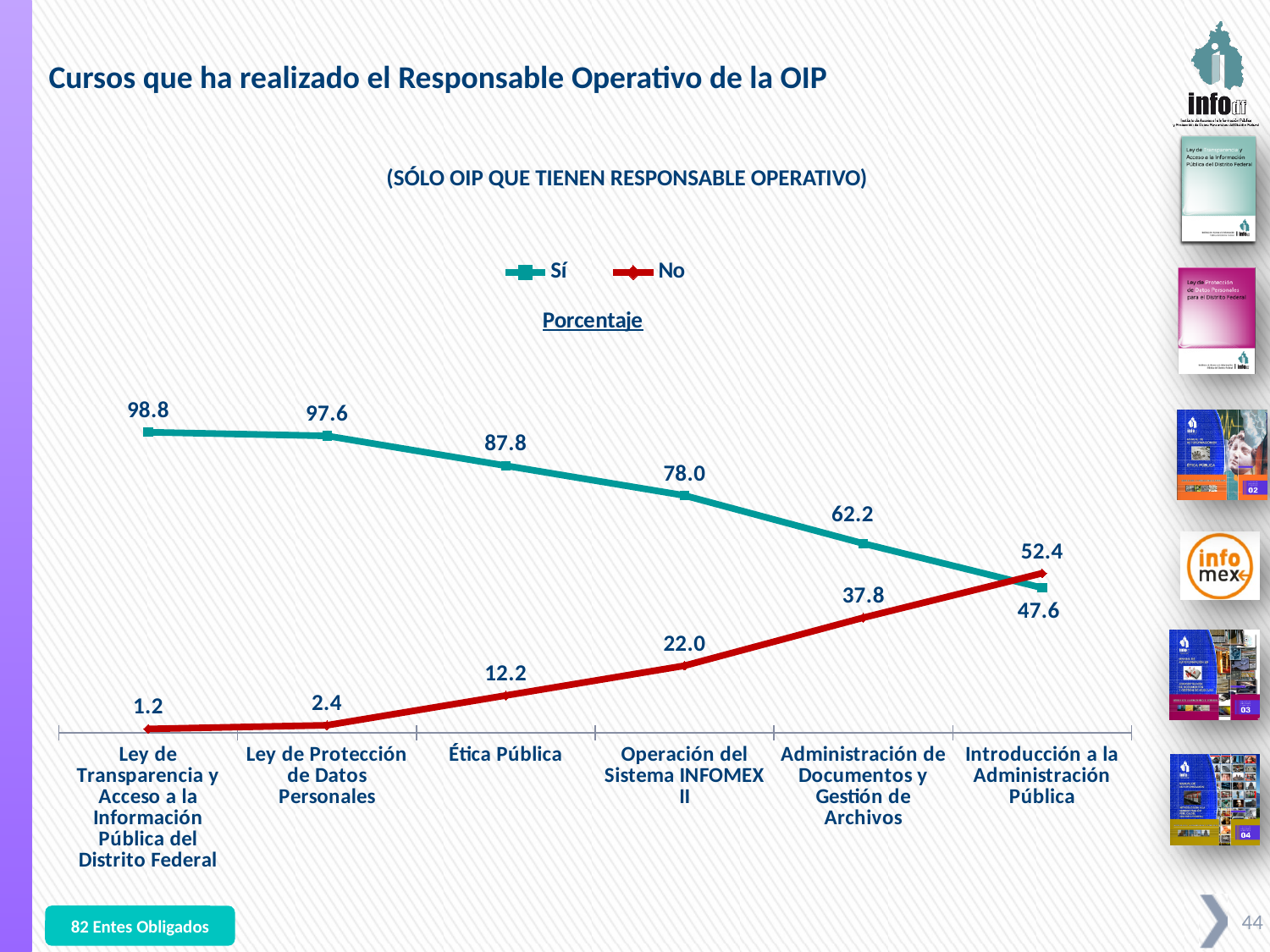
Does the 'No' series rise or fall from left to right along the x axis? rise What type of chart is shown on the slide? line chart Which colour is used for the 'No' series? red For Introducción a la Administración Pública, which is larger, the 'Sí' value or the 'No' value? No How many course categories are plotted along the x axis? 6 What is the 'Sí' value for Introducción a la Administración Pública? 47.6 Which category has the lowest 'No' value? Ley de Transparencia y Acceso a la Información Pública del Distrito Federal What is the 'No' value for Operación del Sistema INFOMEX II? 22.0 What is the 'Sí' value for Ética Pública? 87.8 What is the difference between the 'Sí' and 'No' values for Administración de Documentos y Gestión de Archivos? 24.4 How many series does the legend list? 2 Which category has the highest 'Sí' value? Ley de Transparencia y Acceso a la Información Pública del Distrito Federal